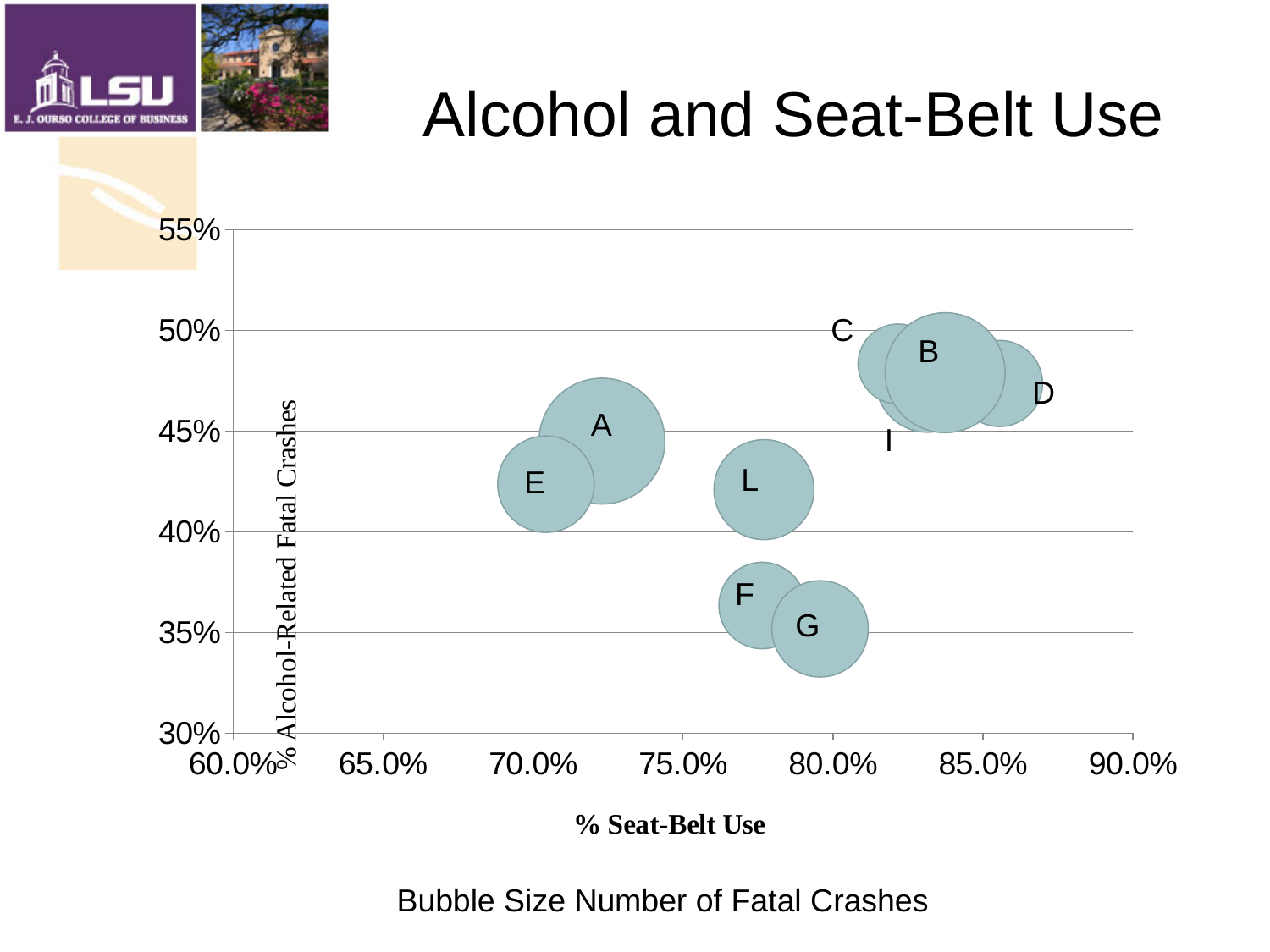
Which labelled bubble has the highest % Seat-Belt Use? D What is the title of the chart? Alcohol and Seat-Belt Use What does the bubble size represent in the chart? Number of Fatal Crashes Which has the higher % Seat-Belt Use, bubble A or bubble E? A Is the % Seat-Belt Use for bubble B greater or less than 80.0%? greater Which labelled bubble has the lowest % Alcohol-Related Fatal Crashes? G Which has the higher % Alcohol-Related Fatal Crashes, bubble L or bubble F? L Is the % Alcohol-Related Fatal Crashes for bubble F greater or less than 40%? less Which labelled bubble has the lowest % Seat-Belt Use? E What kind of chart is shown on the slide? Bubble chart Is the % Alcohol-Related Fatal Crashes for bubble E greater or less than 40%? greater